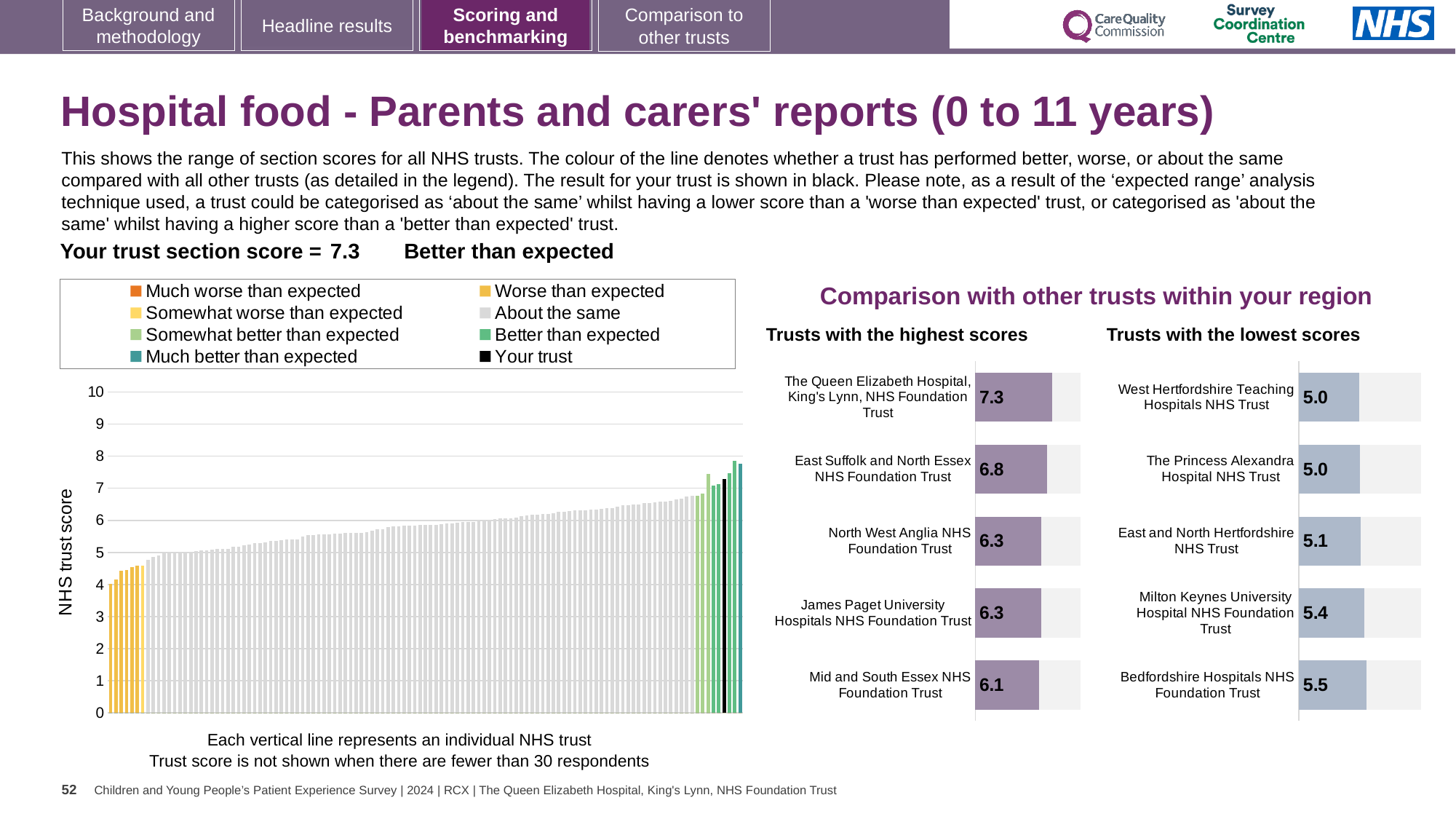
In the 'Trusts with the highest scores' chart, what is the difference between the scores of The Queen Elizabeth Hospital, King's Lynn, NHS Foundation Trust and Mid and South Essex NHS Foundation Trust? 1.2 In the 'Trusts with the highest scores' chart, which trust has the highest score? The Queen Elizabeth Hospital, King's Lynn, NHS Foundation Trust In the 'Trusts with the lowest scores' chart, which trust has the highest score? Bedfordshire Hospitals NHS Foundation Trust In the 'Trusts with the lowest scores' chart, which has the larger score: Milton Keynes University Hospital NHS Foundation Trust or East and North Hertfordshire NHS Trust? Milton Keynes University Hospital NHS Foundation Trust What kind of chart is the large chart on the left showing NHS trust scores? Bar chart In the 'Trusts with the lowest scores' chart, what is the difference between the scores of Bedfordshire Hospitals NHS Foundation Trust and West Hertfordshire Teaching Hospitals NHS Trust? 0.5 In the large chart on the left, do the NHS trust scores rise or fall from left to right? Rise In the 'Trusts with the highest scores' chart, what is the score for East Suffolk and North Essex NHS Foundation Trust? 6.8 In the 'Trusts with the lowest scores' chart, what is the score for Milton Keynes University Hospital NHS Foundation Trust? 5.4 In the 'Trusts with the highest scores' chart, how many trusts are shown? 5 In the large chart on the left, is the value for the black 'Your trust' bar greater or less than 7? greater How many entries does the legend above the large chart on the left list? 8